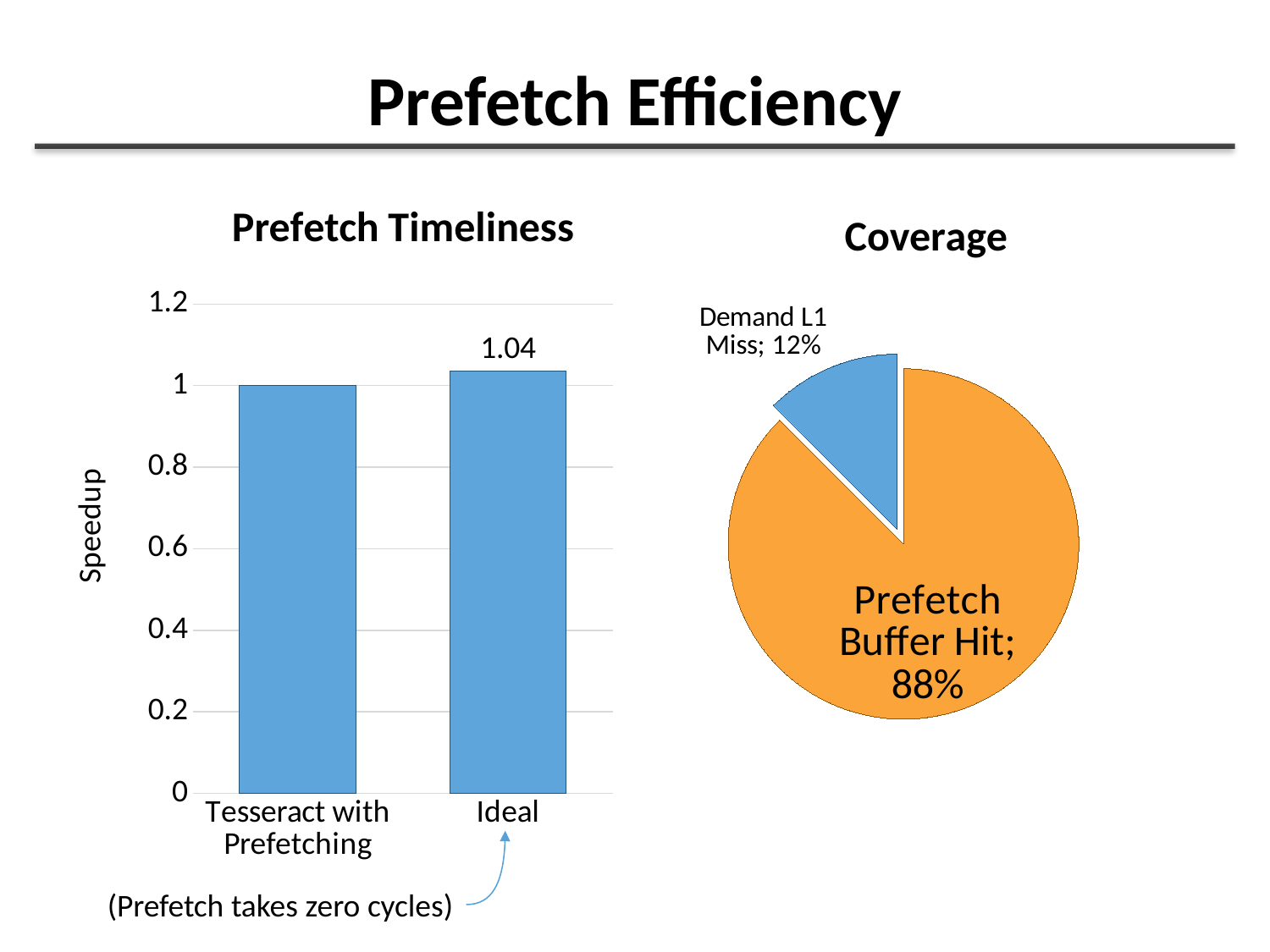
In the Prefetch Timeliness chart, what is the speedup value for Tesseract with Prefetching? 1 In the Coverage chart, what share of the pie is Demand L1 Miss? 12% In the Prefetch Timeliness chart, is the value for Ideal greater or less than 1.2? less In the Prefetch Timeliness chart, what is the label of the y axis? Speedup In the Coverage chart, what share of the pie is Prefetch Buffer Hit? 88% In the Prefetch Timeliness chart, how many categories are shown on the x axis? 2 In the Prefetch Timeliness chart, what is the speedup value for Ideal? 1.04 In the Prefetch Timeliness chart, which category has the lower speedup? Tesseract with Prefetching In the Prefetch Timeliness chart, which category has the higher speedup? Ideal In the Prefetch Timeliness chart, is the value for Tesseract with Prefetching greater or less than 0.8? greater What kind of chart is the Coverage chart? pie chart What kind of chart is the Prefetch Timeliness chart? bar chart